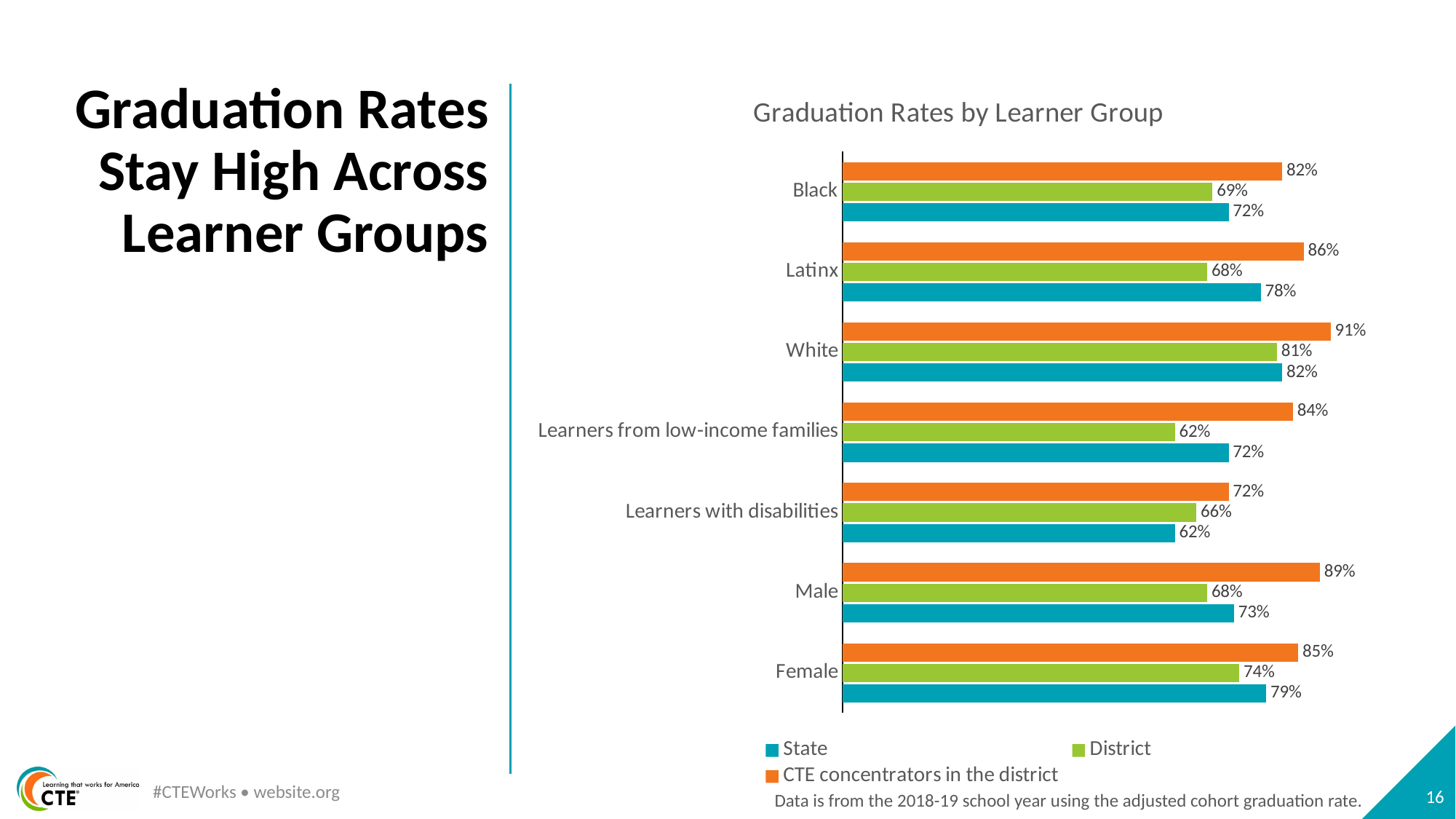
Which is larger for Latinx learners: the State rate or the District rate? State How many learner groups are shown on the chart? 7 Which learner group has the lowest District graduation rate? Learners from low-income families What kind of chart is shown on the slide? Bar chart What is the graduation rate for CTE concentrators in the district among White learners? 91% What is the State graduation rate for Learners with disabilities? 62% What is the District graduation rate for Female learners? 74% Which series is shown in orange? CTE concentrators in the district Which learner group has the highest graduation rate for CTE concentrators in the district? White How many series does the legend list? 3 What is the difference between the CTE concentrators in the district rate and the District rate for Male learners? 21% What is the title of the chart? Graduation Rates by Learner Group